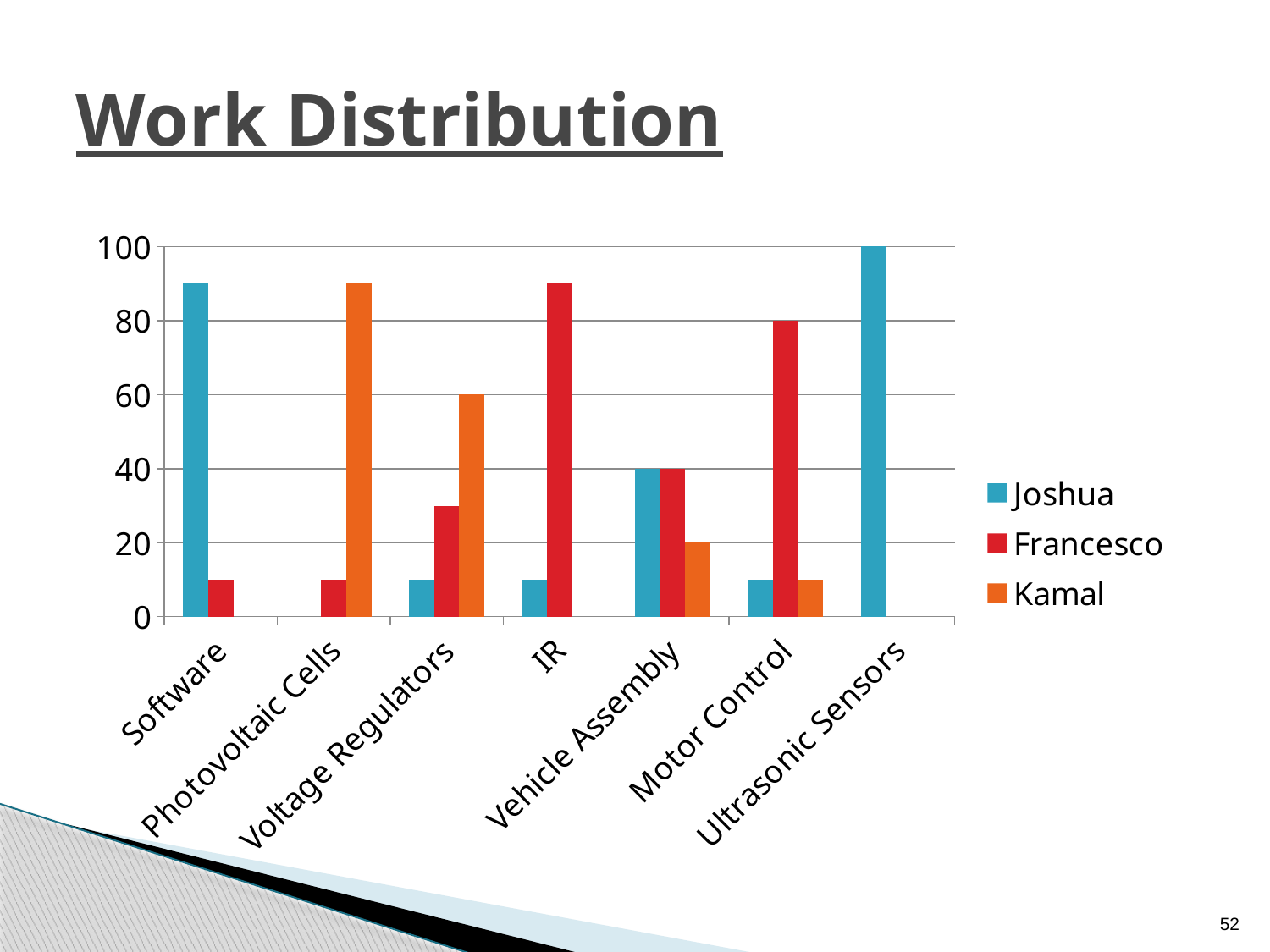
In which category is Joshua's value highest? Ultrasonic Sensors Is the value for Joshua in Software greater or less than 80? greater Which is larger in Photovoltaic Cells, Francesco's value or Kamal's value? Kamal What is the value for Francesco in Motor Control? 80 What kind of chart is shown on the slide? bar chart How many categories are shown on the x axis? 7 What is the difference between Francesco's and Kamal's values in Vehicle Assembly? 20 In which category is Francesco's value highest? IR What is the value for Joshua in Ultrasonic Sensors? 100 What is the value for Kamal in Vehicle Assembly? 20 What is the value for Kamal in Voltage Regulators? 60 How many series does the legend list? 3